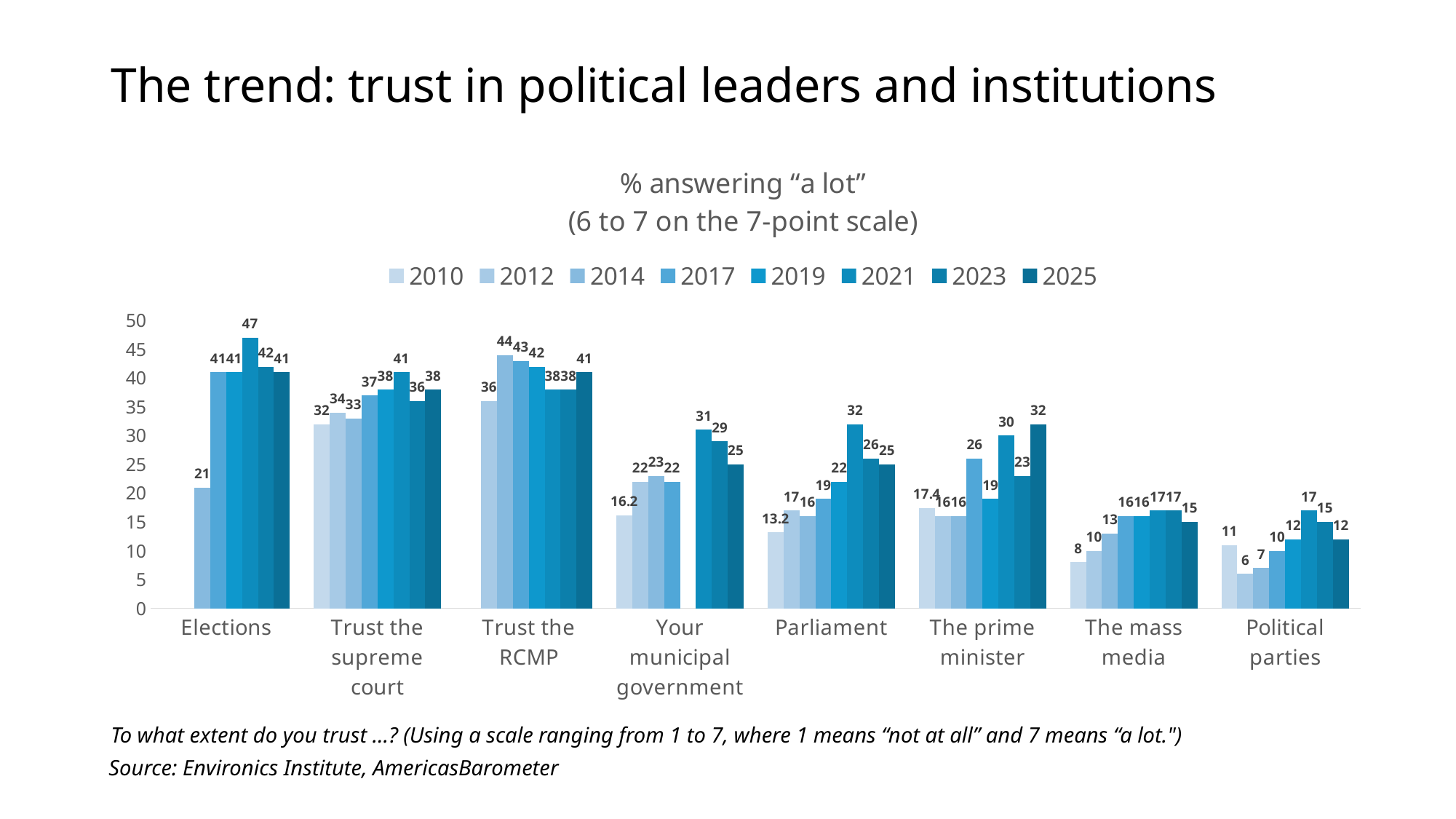
Which year has the lowest value for Political parties? 2012 What is the 2021 value for Trust the supreme court? 41 What is the difference between the 2025 and 2010 values for The mass media? 7 Which is larger, the 2021 value for Parliament or the 2021 value for The prime minister? Parliament What is the highest value shown for Elections? 47 What is the 2010 value for Parliament? 13.2 How many categories are shown on the x axis? 8 How many series does the legend list? 8 What is the 2025 value for The prime minister? 32 What kind of chart is shown on the slide? Bar chart What is the subtitle shown above the legend? % answering "a lot" (6 to 7 on the 7-point scale)